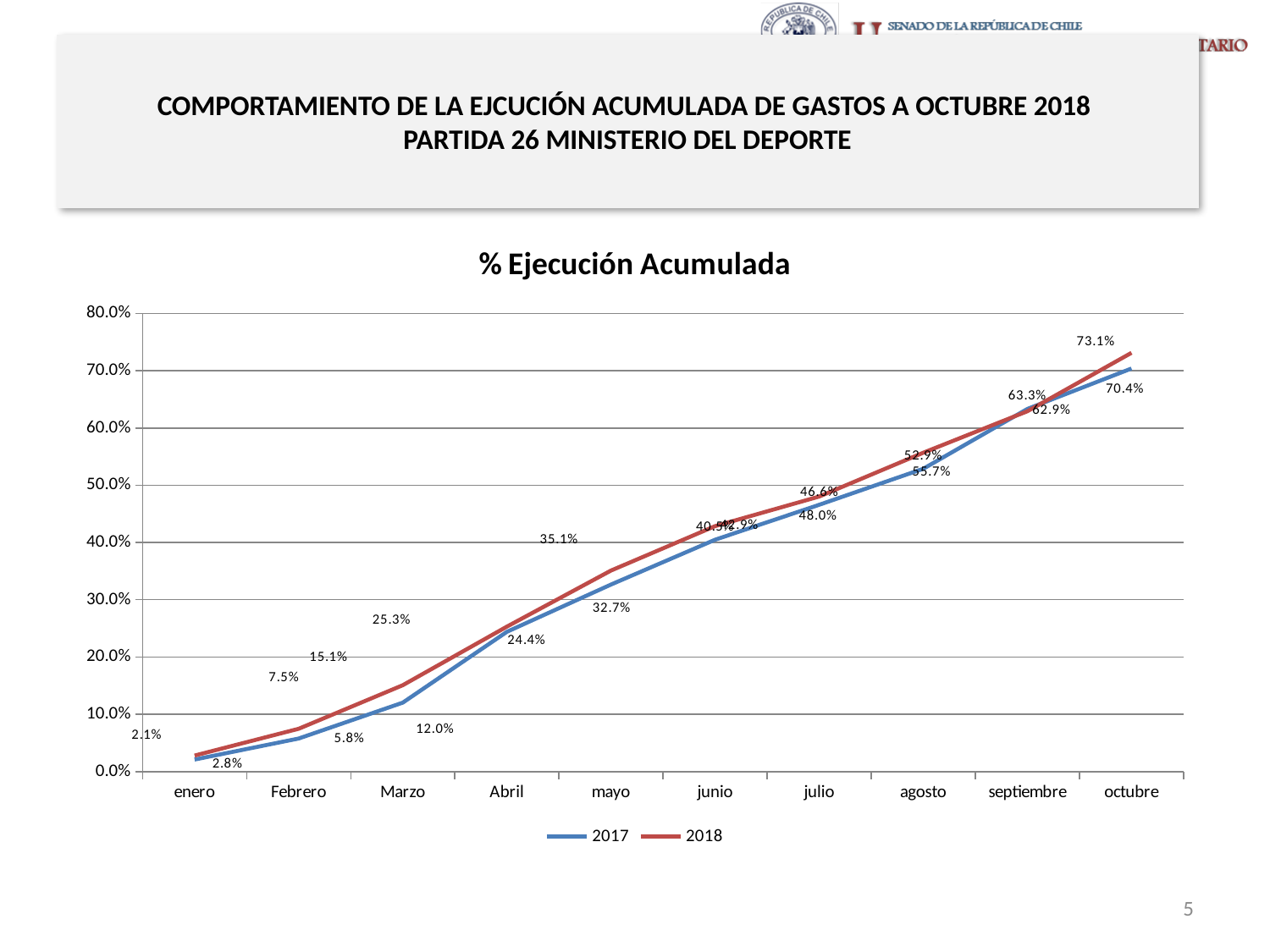
What is the 2017 value for Marzo? 12.0% What is the difference between the 2018 and 2017 values for octubre? 2.7 percentage points What is the 2017 value for octubre? 70.4% In which month does the 2018 series reach its highest value? octubre What is the 2018 value for Abril? 25.3% How many series does the legend list? 2 Is the 2018 value for junio greater or less than 40.0%? greater Do the values rise or fall from enero to octubre? rise How many months are plotted along the x axis? 10 What is the 2018 value for octubre? 73.1% What kind of chart is shown on the slide? line chart For mayo, which series has the larger value, 2017 or 2018? 2018